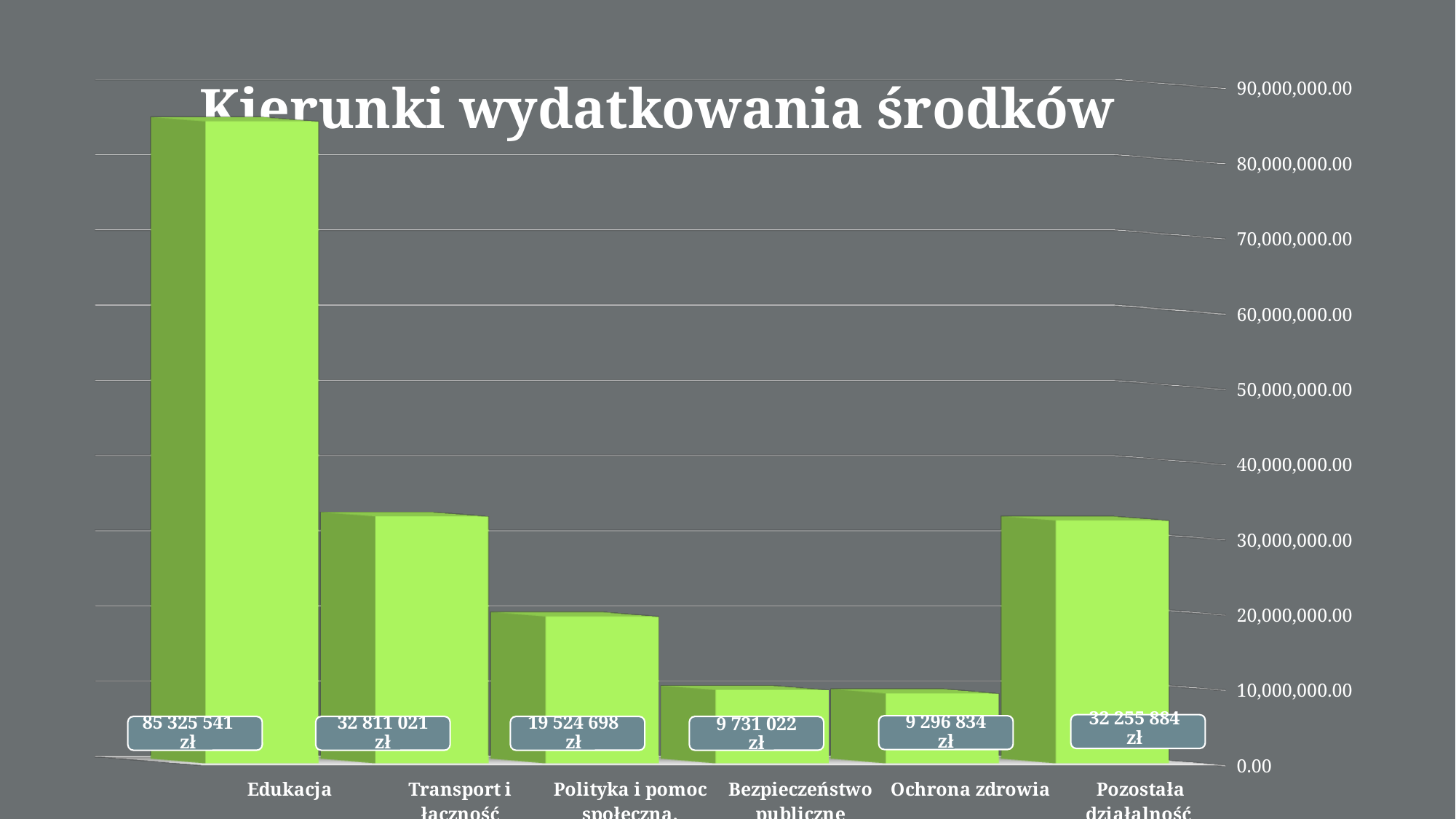
Is the value for Edukacja greater or less than 80,000,000.00? greater Which category has the highest value? Edukacja What is the difference between the values for Edukacja and Transport i łączność? 52 514 520 zł Which category has the lowest value? Ochrona zdrowia What is the value for Ochrona zdrowia? 9 296 834 zł What is the title of the chart? Kierunki wydatkowania środków What is the value for Pozostała działalność? 32 255 884 zł How many categories are shown in the chart? 6 What is the difference between the values for Bezpieczeństwo publiczne and Ochrona zdrowia? 434 188 zł What is the value for Edukacja? 85 325 541 zł Which is larger, the value for Transport i łączność or the value for Pozostała działalność? Transport i łączność What is the value for Transport i łączność? 32 811 021 zł